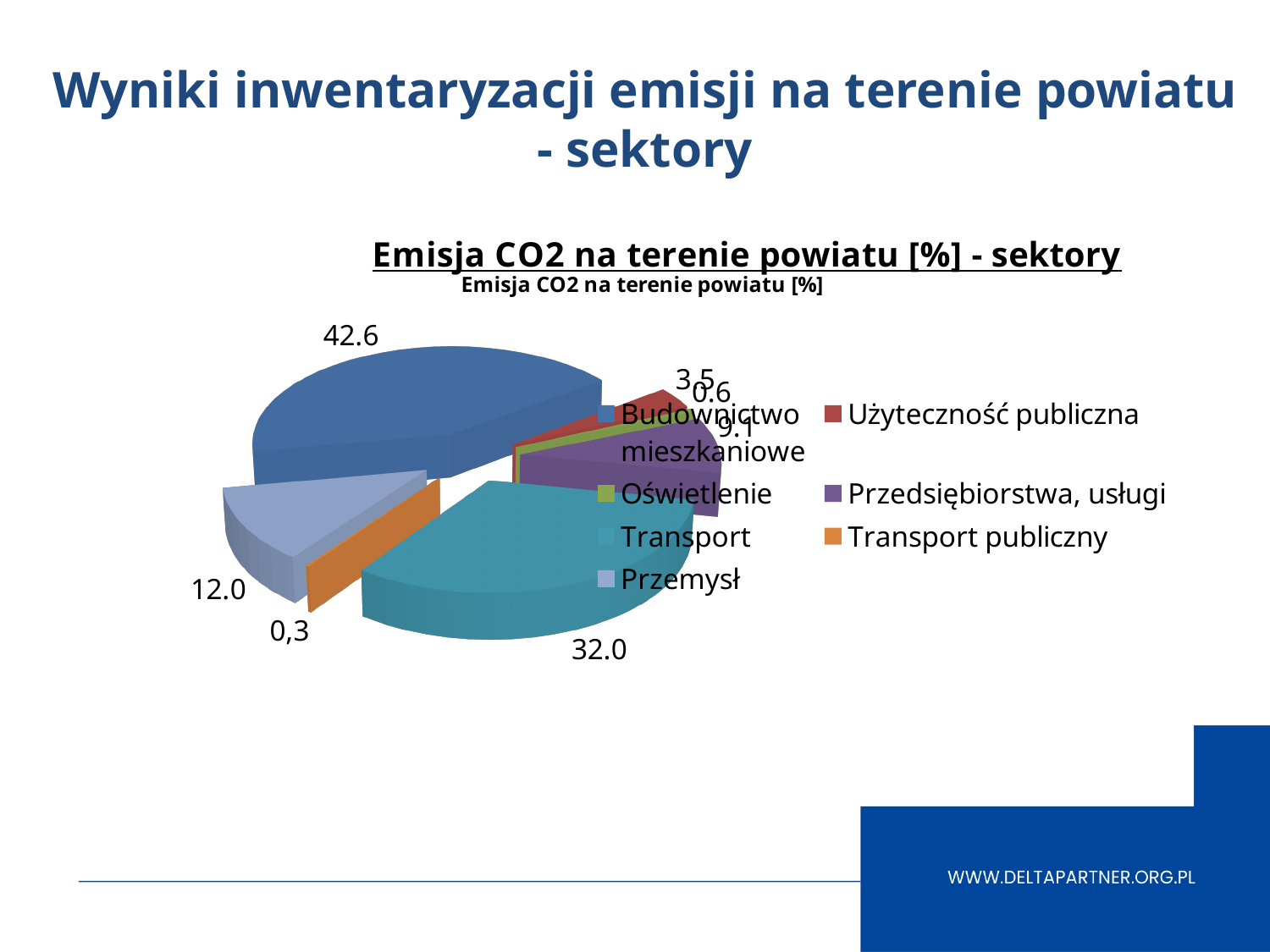
What kind of chart is shown on the slide? pie chart What is the value for Transport? 32.0 What is the value for Przemysł? 12.0 Which is larger, the value for Przemysł or the value for Przedsiębiorstwa, usługi? Przemysł Which sector has the largest share of the pie? Budownictwo mieszkaniowe What is the value for Przedsiębiorstwa, usługi? 9.1 What is the value for Budownictwo mieszkaniowe? 42.6 Which sector has the smallest share of the pie? Transport publiczny What is the value for Transport publiczny? 0,3 What is the title of the chart? Emisja CO2 na terenie powiatu [%] - sektory What is the difference between the values for Budownictwo mieszkaniowe and Transport? 10.6 How many sectors does the legend list? 7